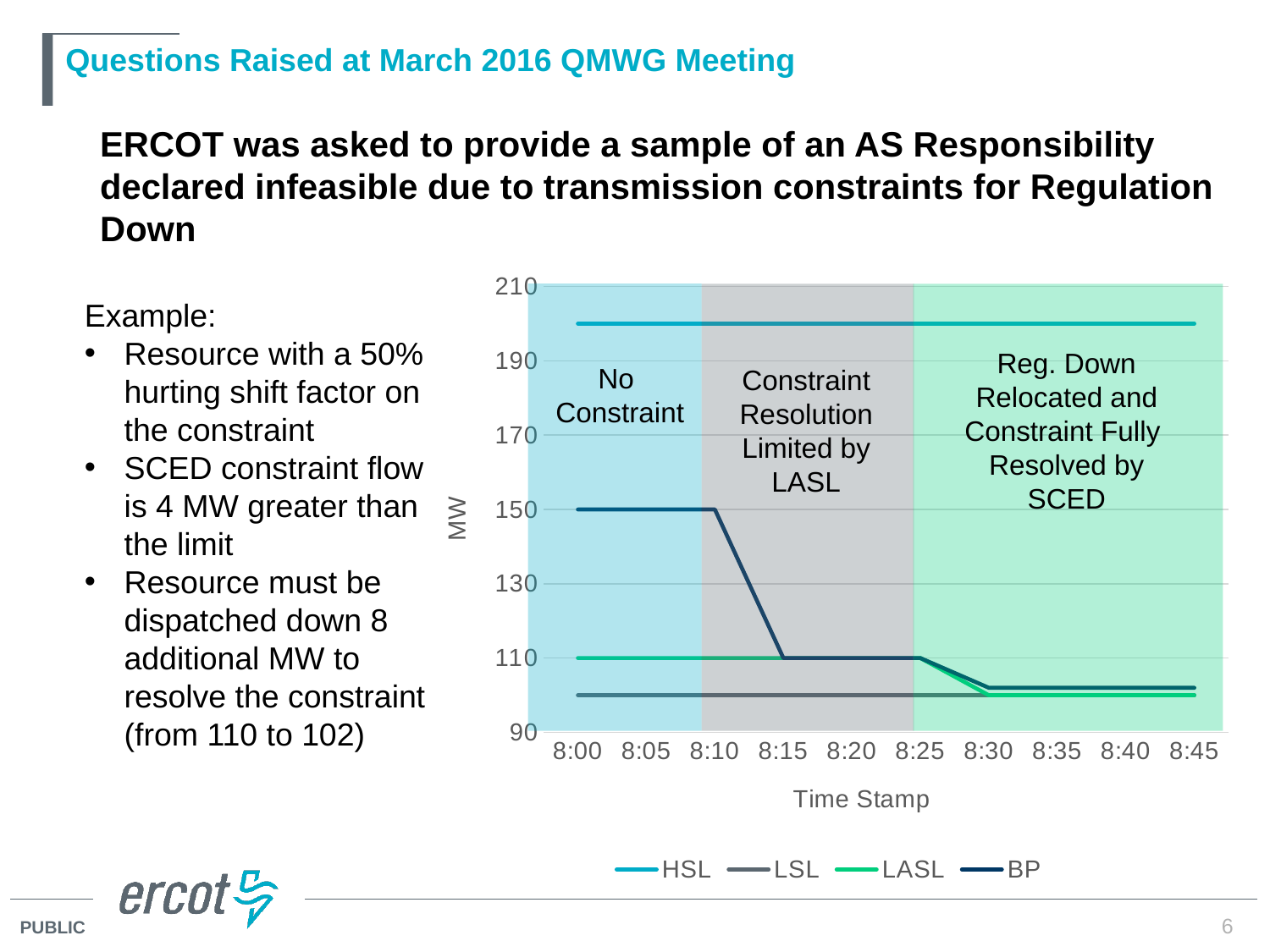
Which series has the lowest value at 8:00? LSL Is the LSL value at 8:00 greater or less than 110? less By how much does the BP value at 8:00 exceed the BP value at 8:20? 40 What is the BP value at 8:00? 150 How many series does the chart legend list? 4 What is the BP value at 8:20? 110 Does the BP series rise or fall between 8:10 and 8:15? Fall What kind of chart is shown on the slide? Line chart Is the HSL value at 8:00 greater or less than 190? greater Which series has the highest value at 8:00? HSL How many time stamps are shown along the x axis of the chart? 10 What is the LASL value at 8:10? 110